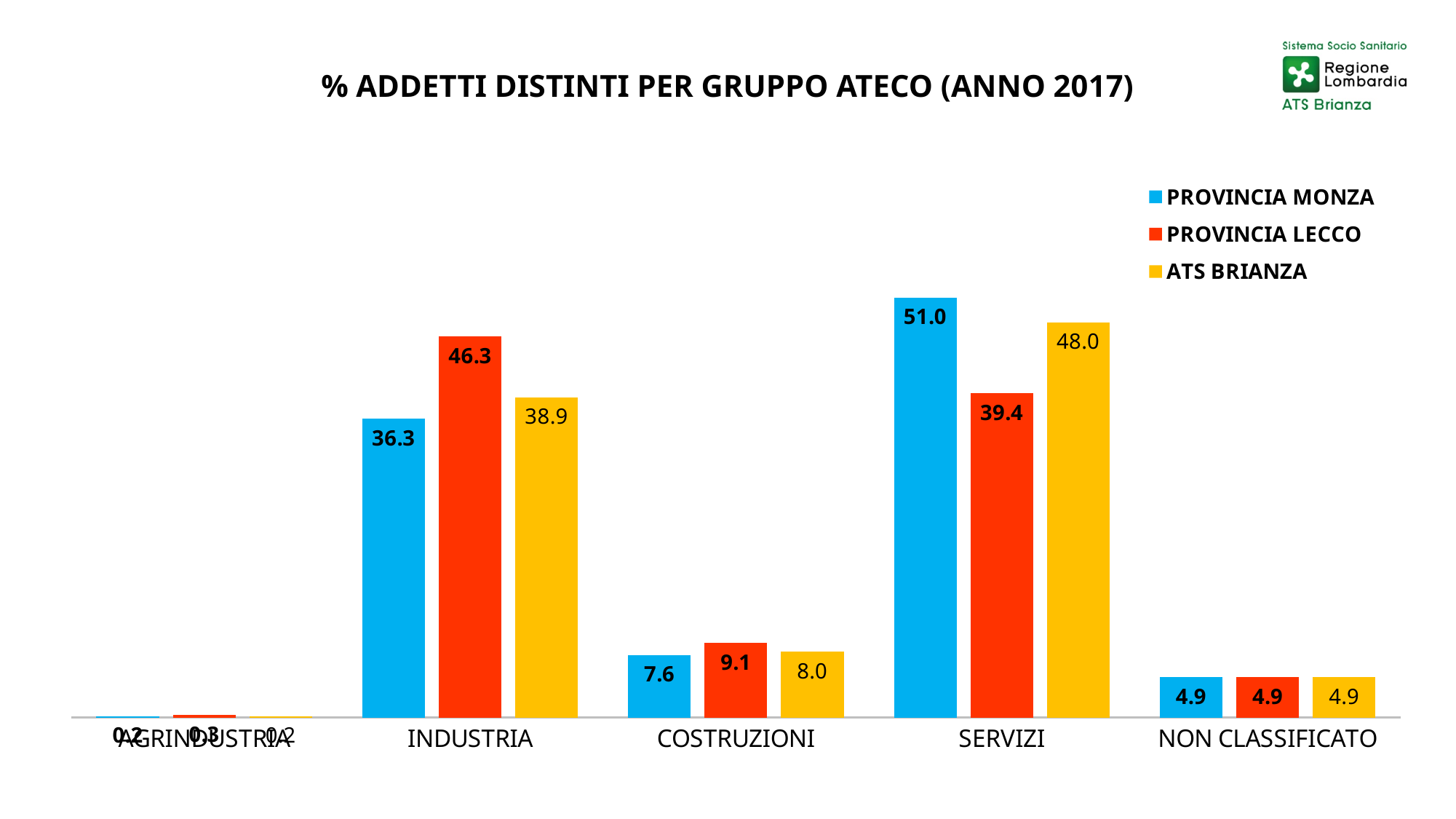
What is the value for PROVINCIA LECCO in the INDUSTRIA category? 46.3 What is the difference between the PROVINCIA MONZA and PROVINCIA LECCO values in the SERVIZI category? 11.6 What is the difference between the PROVINCIA LECCO and PROVINCIA MONZA values in the INDUSTRIA category? 10.0 What is the value for PROVINCIA MONZA in the SERVIZI category? 51.0 Which category has the highest value for PROVINCIA LECCO? INDUSTRIA What is the value for ATS BRIANZA in the SERVIZI category? 48.0 How many categories are shown on the x axis? 5 What kind of chart is shown on the slide? Bar chart How many series does the legend list? 3 In the COSTRUZIONI category, which series has the larger value: PROVINCIA MONZA or PROVINCIA LECCO? PROVINCIA LECCO What is the value for ATS BRIANZA in the COSTRUZIONI category? 8.0 Which category has the highest value for PROVINCIA MONZA? SERVIZI